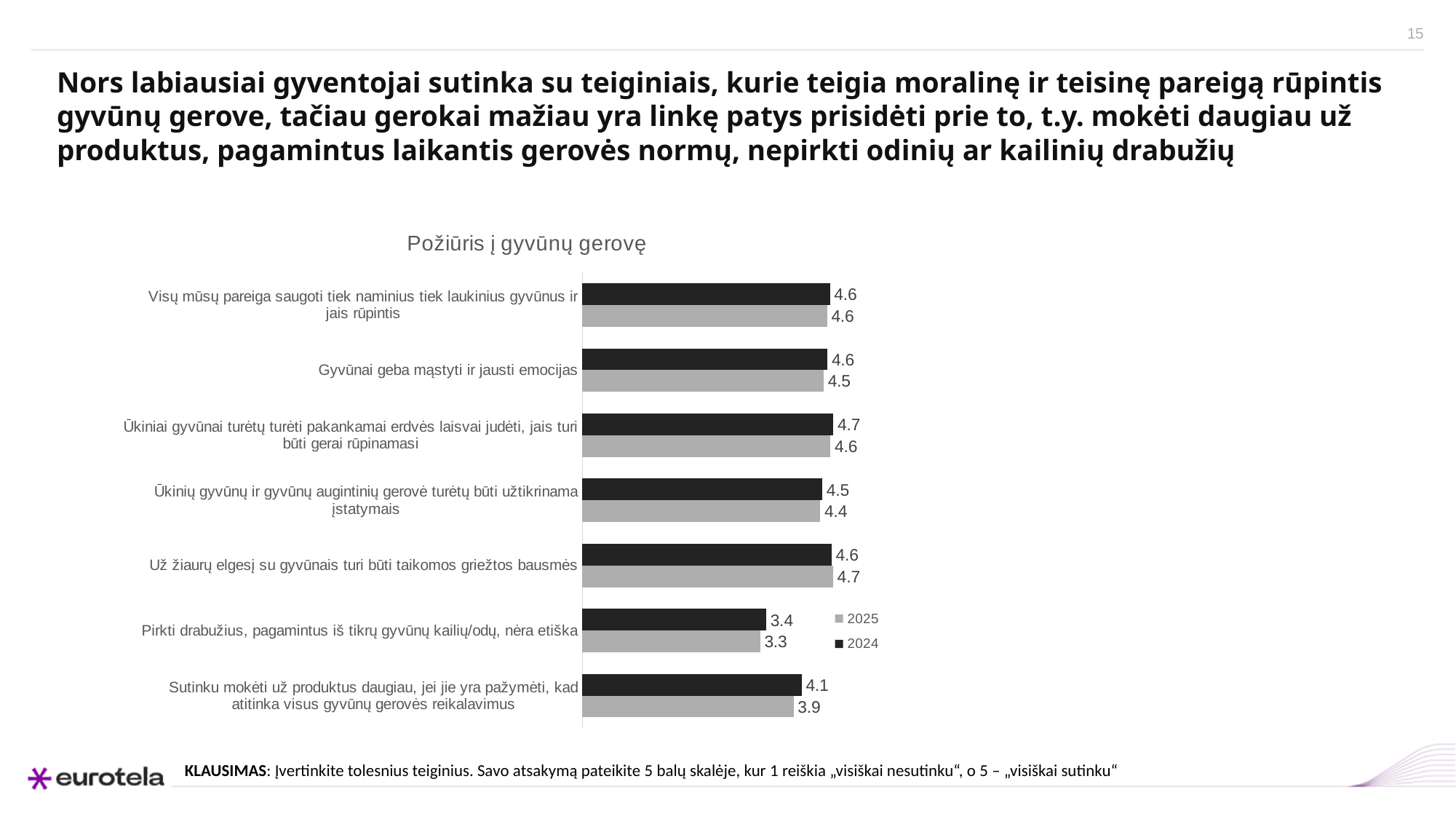
What is the 2025 value for "Sutinku mokėti už produktus daugiau, jei jie yra pažymėti, kad atitinka visus gyvūnų gerovės reikalavimus"? 3.9 What is the 2024 value for "Pirkti drabužius, pagamintus iš tikrų gyvūnų kailių/odų, nėra etiška"? 3.4 What is the title of the chart? Požiūris į gyvūnų gerovę For "Už žiaurų elgesį su gyvūnais turi būti taikomos griežtos bausmės", which year has the larger value, 2024 or 2025? 2025 Which statement has the lowest 2025 value? Pirkti drabužius, pagamintus iš tikrų gyvūnų kailių/odų, nėra etiška How many statements (categories) are shown in the chart? 7 What is the difference between the 2024 and 2025 values for "Sutinku mokėti už produktus daugiau, jei jie yra pažymėti, kad atitinka visus gyvūnų gerovės reikalavimus"? 0.2 Which colour represents the 2024 series in the chart? black What is the 2025 value for "Gyvūnai geba mąstyti ir jausti emocijas"? 4.5 How many series does the legend list? 2 What type of chart is shown on the slide? bar chart Which statement has the highest 2025 value? Už žiaurų elgesį su gyvūnais turi būti taikomos griežtos bausmės